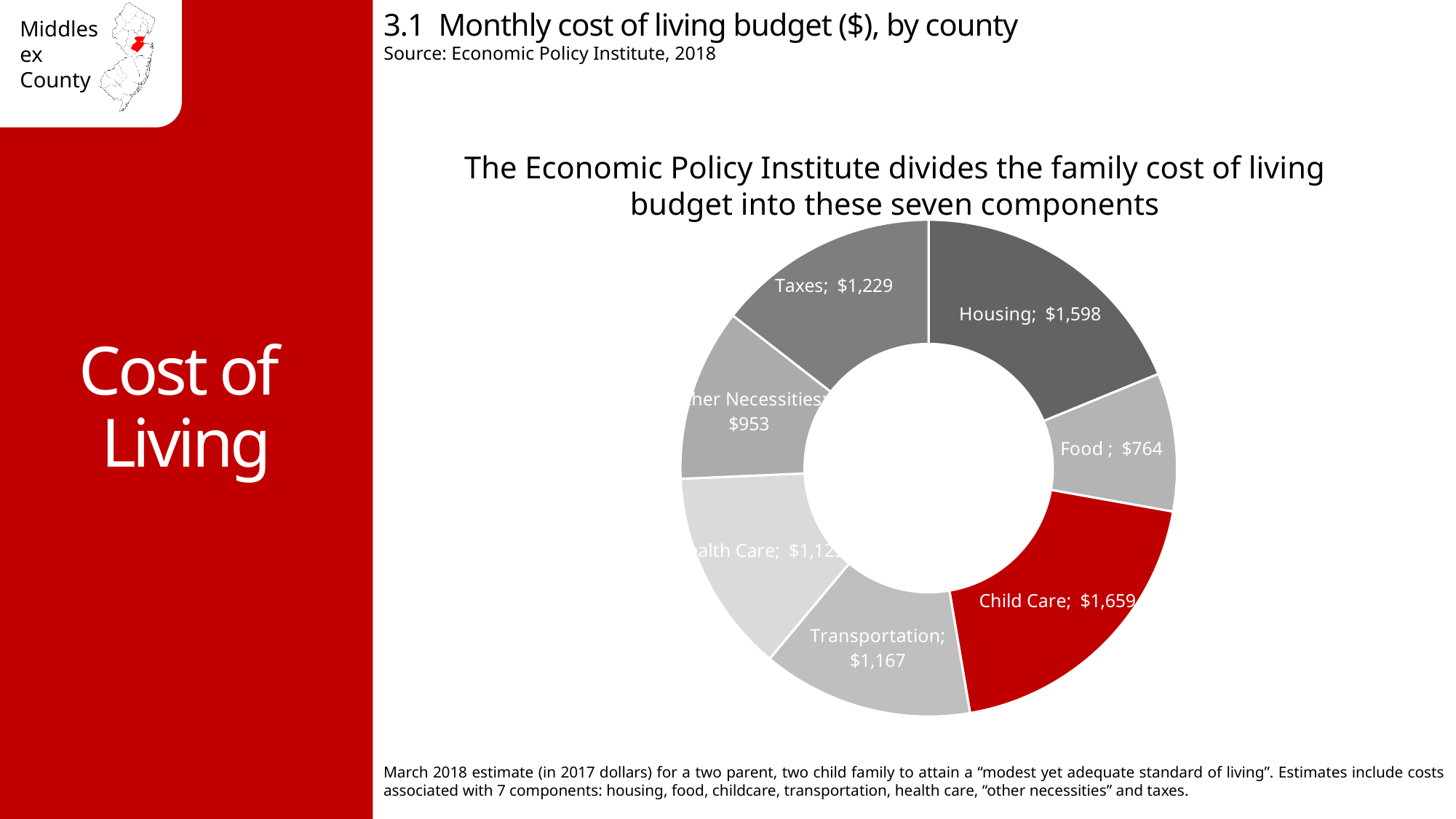
Which component has the largest monthly cost in the chart? Child Care Which component is shown in red in the chart? Child Care What is the monthly cost for Taxes in the chart? $1,229 How many components are shown in the chart? 7 How much more is the monthly cost of Child Care than Housing? $61 What is the monthly cost for Housing in the chart? $1,598 Which is larger, the monthly cost for Taxes or for Other Necessities? Taxes What is the monthly cost for Food in the chart? $764 What is the monthly cost for Transportation in the chart? $1,167 Which component has the smallest monthly cost in the chart? Food How much more is the monthly cost of Taxes than Transportation? $62 What is the monthly cost for Child Care in the chart? $1,659